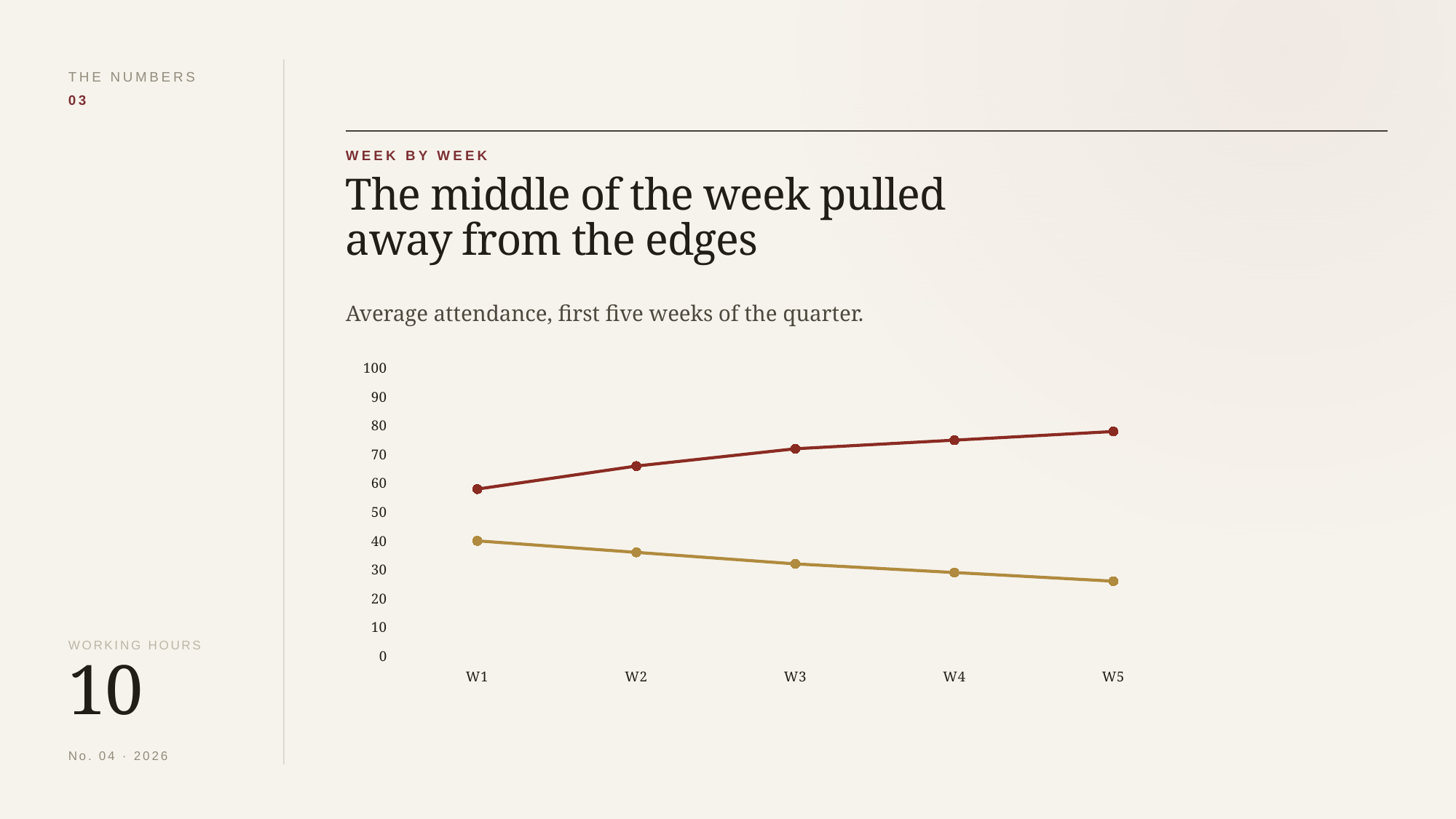
How many lines are plotted on the chart? 2 At W3, which line has the higher value, the red line or the gold line? the red line Is the value of the red line at W1 greater or less than 50? greater What kind of chart is shown on the slide? line chart Does the gold line rise or fall from W1 to W5? falls At which week does the gold line reach its lowest value? W5 Does the red line rise or fall from W1 to W5? rises Is the value of the gold line at W2 greater or less than 40? less At which week does the red line reach its highest value? W5 How many weeks are plotted along the x axis? 5 Is the value of the gold line at W5 greater or less than 30? less